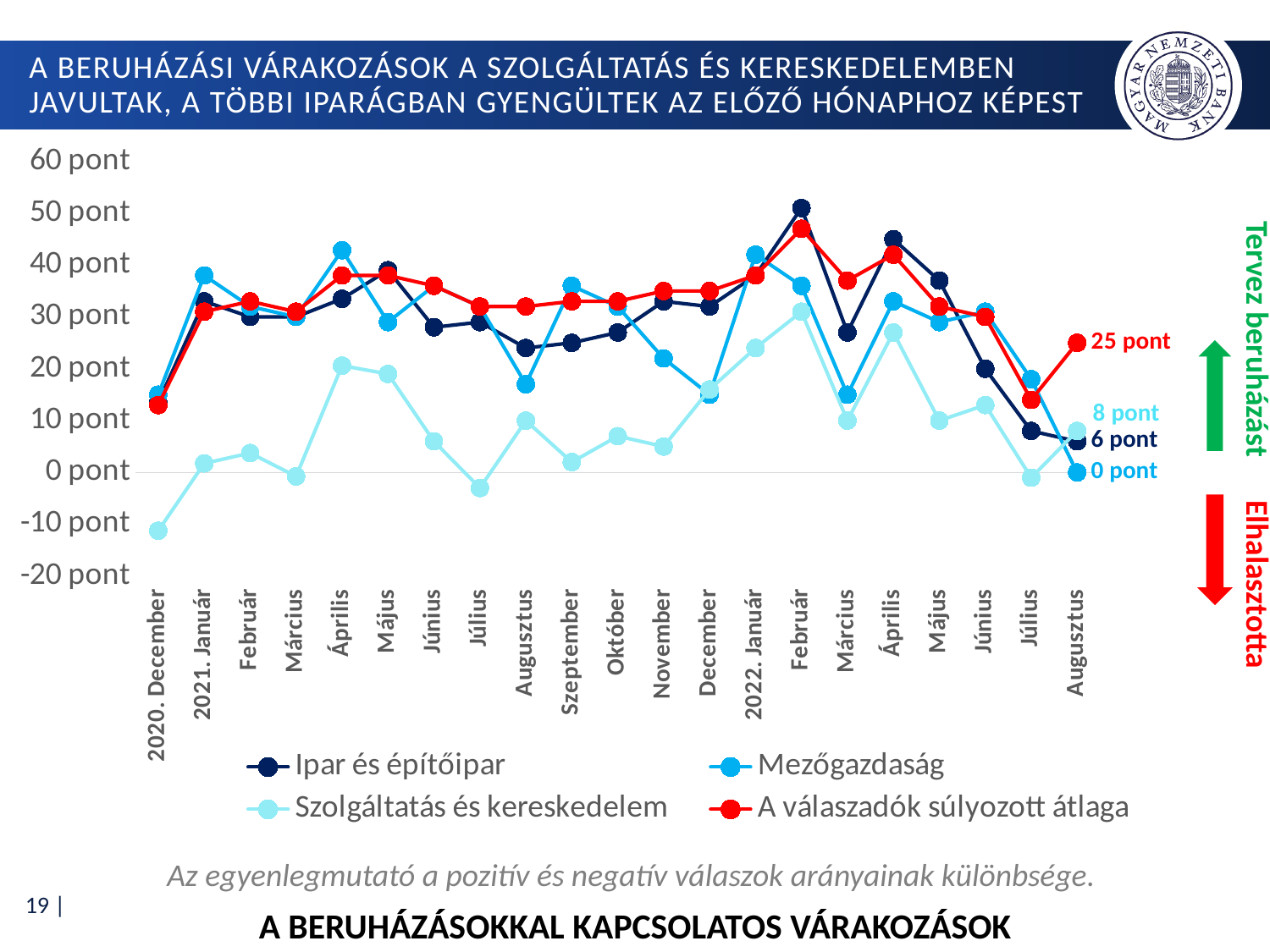
Which series has the highest value in 2022. Augusztus? A válaszadók súlyozott átlaga What is the difference between A válaszadók súlyozott átlaga and Ipar és építőipar in 2022. Augusztus? 19 pont Which series has the lowest value in 2022. Augusztus? Mezőgazdaság Is the value for Ipar és építőipar in 2022. Február greater or less than 40 pont? greater What kind of chart is shown on the slide? line chart Does the Ipar és építőipar series rise or fall from 2022. Április to 2022. Július? fall How many months are shown on the x axis? 21 What is the value of A válaszadók súlyozott átlaga in 2022. Augusztus? 25 pont What is the value of Ipar és építőipar in 2022. Augusztus? 6 pont What is the value of Szolgáltatás és kereskedelem in 2022. Augusztus? 8 pont How many series does the legend list? 4 What is the value of Mezőgazdaság in 2022. Augusztus? 0 pont